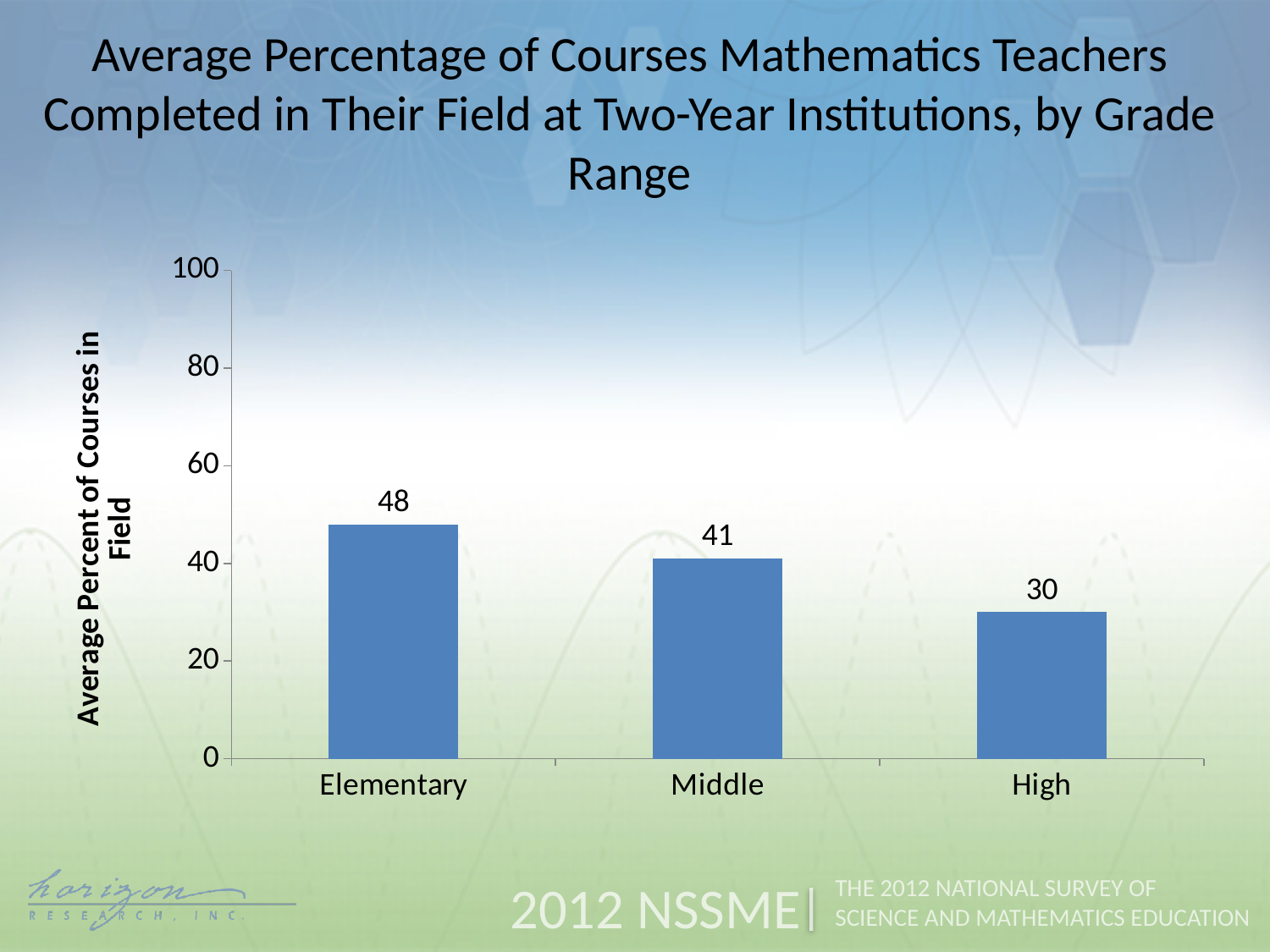
How many grade ranges are shown on the x axis? 3 Do the values rise or fall from Elementary to High along the x axis? fall Is the value for Elementary greater or less than 40? greater Which is larger, the value for Middle or the value for High? Middle Which grade range has the highest average percent of courses in field? Elementary What kind of chart is shown on the slide? bar chart What is the difference between the values for Elementary and High? 18 What is the value for Middle? 41 What is the value for Elementary? 48 Which grade range has the lowest average percent of courses in field? High What is the value for High? 30 What is the difference between the values for Middle and High? 11